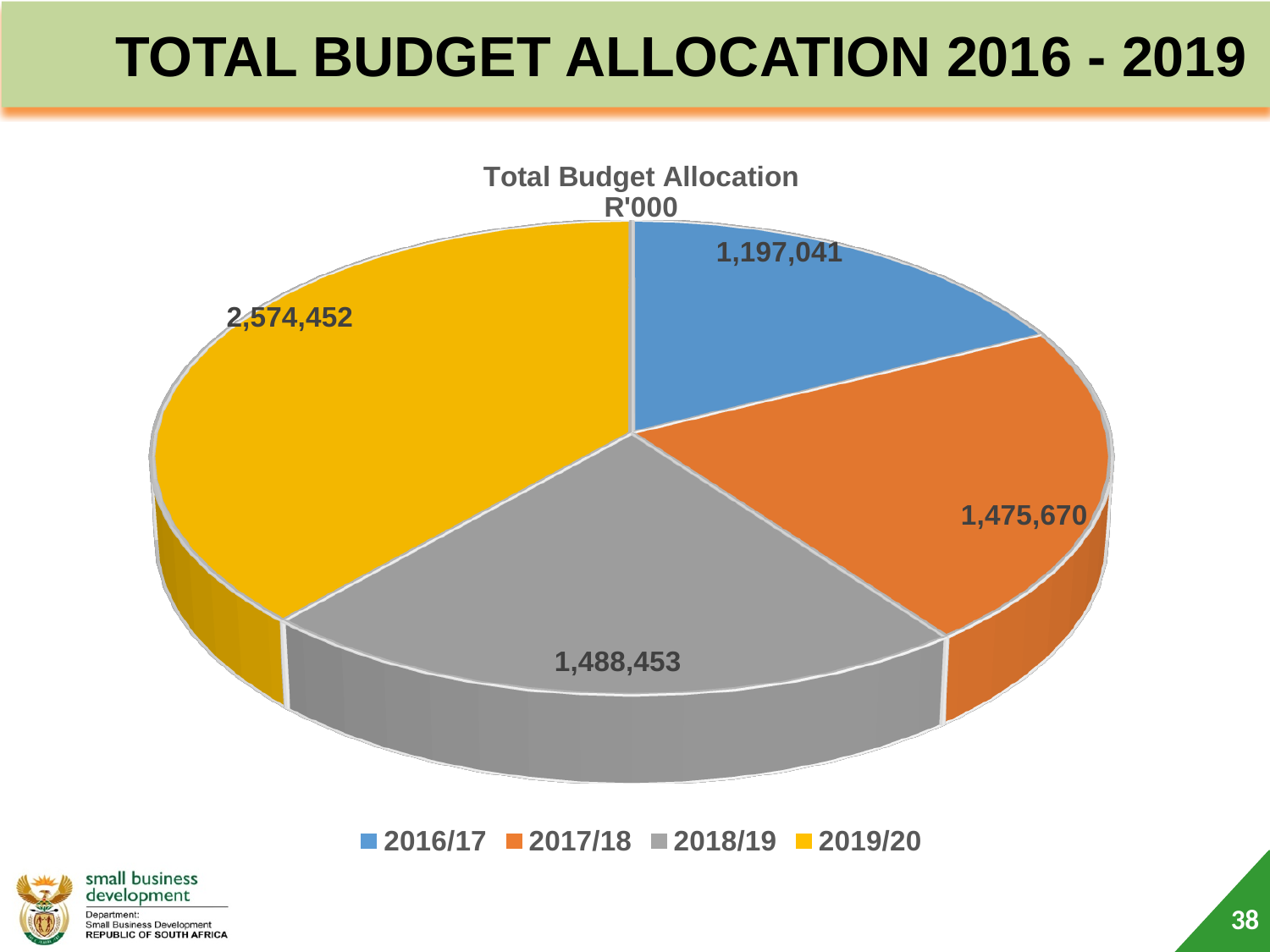
How many slices does the pie chart have? 4 Which year has the largest budget allocation? 2019/20 Which is larger, the allocation for 2018/19 or for 2017/18? 2018/19 What is the difference between the 2018/19 and 2017/18 allocations? 12,783 What kind of chart is shown on the slide? Pie chart What is the title of the chart? Total Budget Allocation R'000 What is the difference between the 2019/20 and 2016/17 allocations? 1,377,411 What is the value for 2018/19 in the pie chart? 1,488,453 What colour is the 2019/20 slice? Yellow Which year has the smallest budget allocation? 2016/17 What is the value for 2019/20 in the pie chart? 2,574,452 What is the value for 2016/17 in the pie chart? 1,197,041